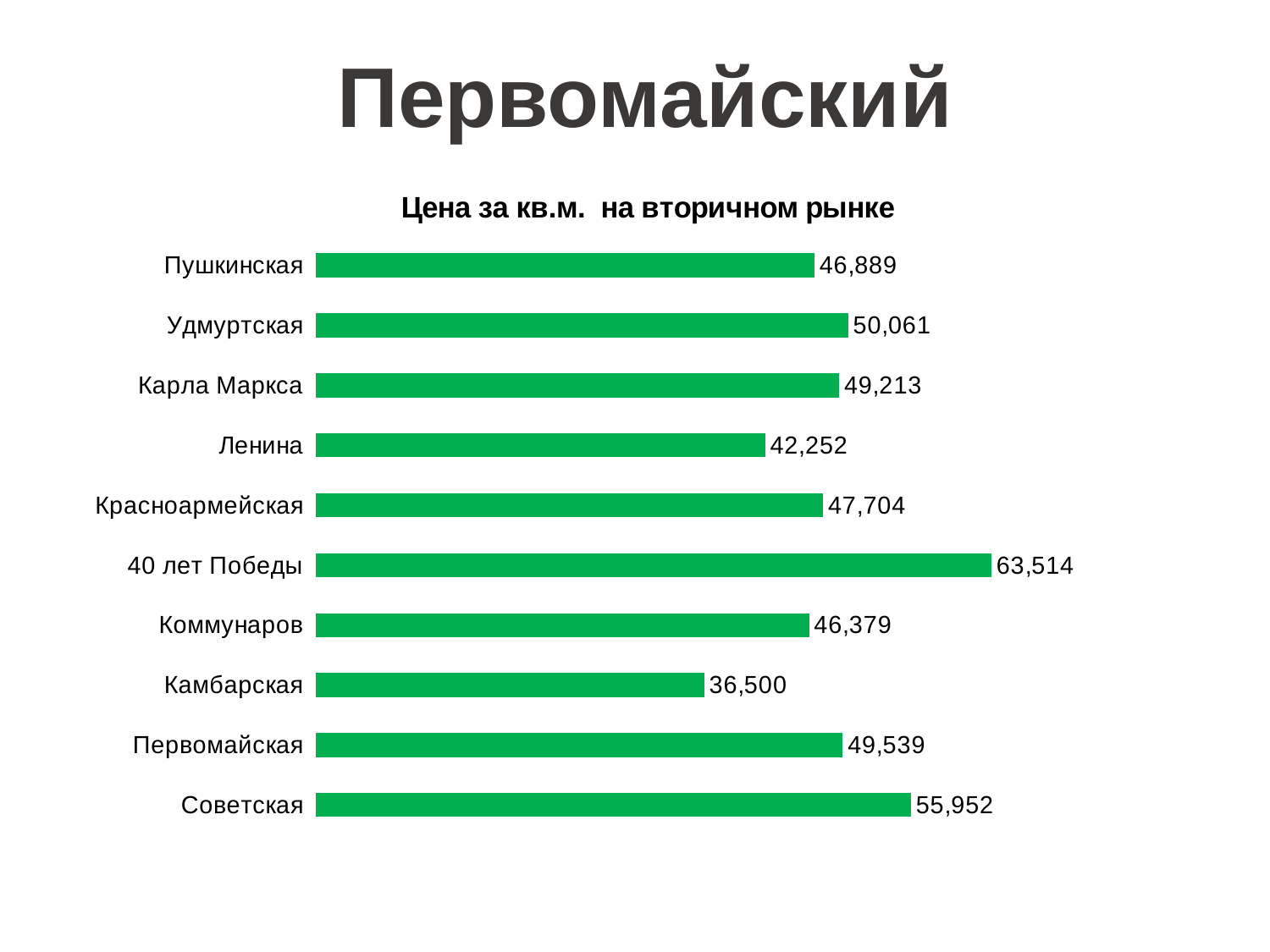
What is the value for Советская? 55,952 What is the value for Пушкинская? 46,889 What is the difference between the values for Удмуртская and Ленина? 7,809 What is the value for Камбарская? 36,500 What is the title of the chart? Цена за кв.м. на вторичном рынке How many categories are shown in the chart? 10 Which category has the lowest value? Камбарская What is the difference between the values for 40 лет Победы and Камбарская? 27,014 What is the value for 40 лет Победы? 63,514 Which is larger, the value for Советская or the value for Первомайская? Советская What kind of chart is shown on the slide? bar chart Which category has the highest value? 40 лет Победы